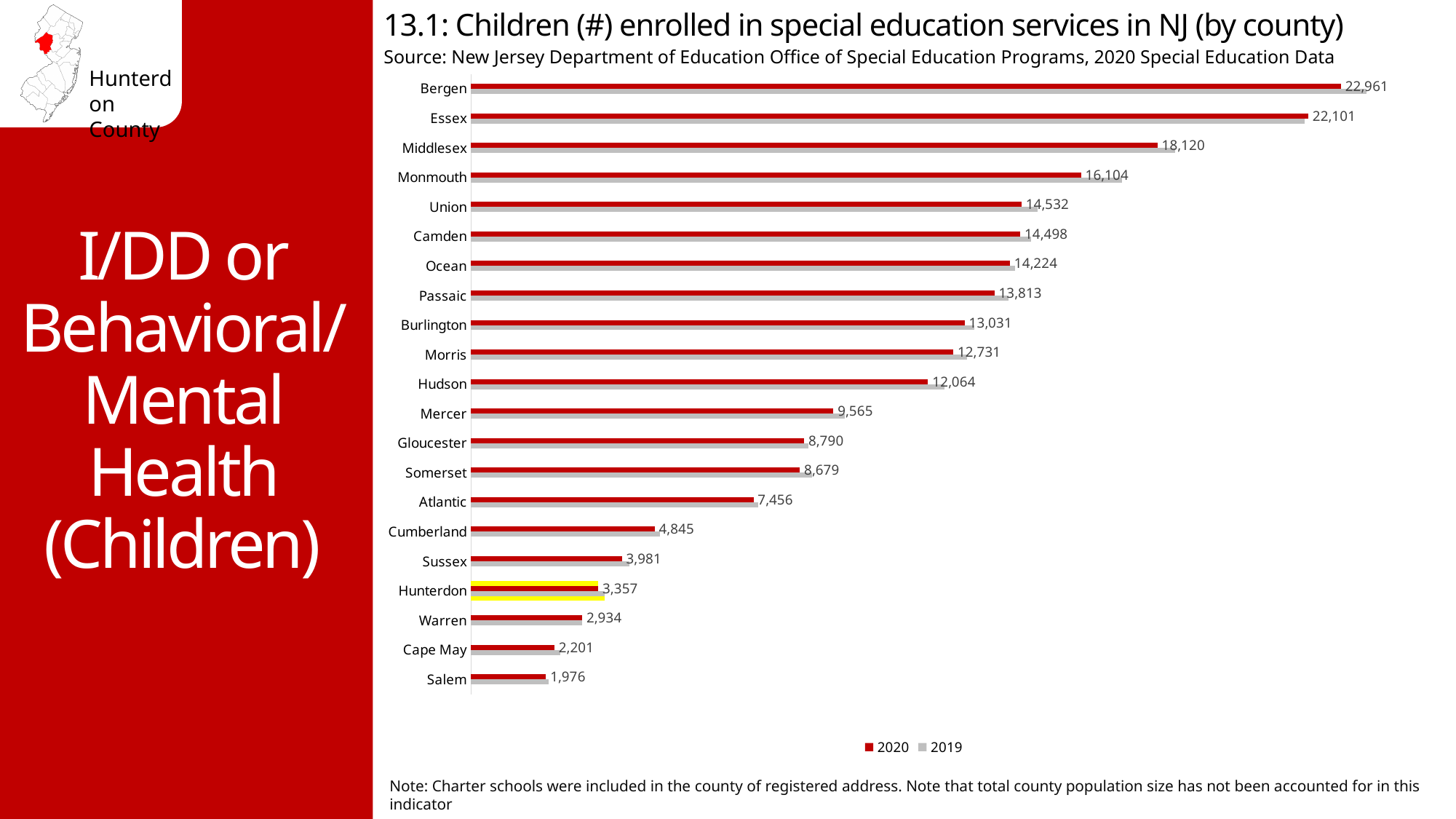
What is the 2020 value for Bergen? 22,961 What is the difference between the 2020 values for Bergen and Essex? 860 Which has a larger 2020 value, Middlesex or Monmouth? Middlesex How many counties are shown on the chart? 21 What kind of chart is shown? Bar chart What is the 2020 value for Mercer? 9,565 Which county's bars are highlighted in yellow? Hunterdon Which county has the lowest 2020 value? Salem How many series does the legend list? 2 What is the 2020 value for Hunterdon? 3,357 Which county has the highest 2020 value? Bergen What is the difference between the 2020 values for Hunterdon and Warren? 423